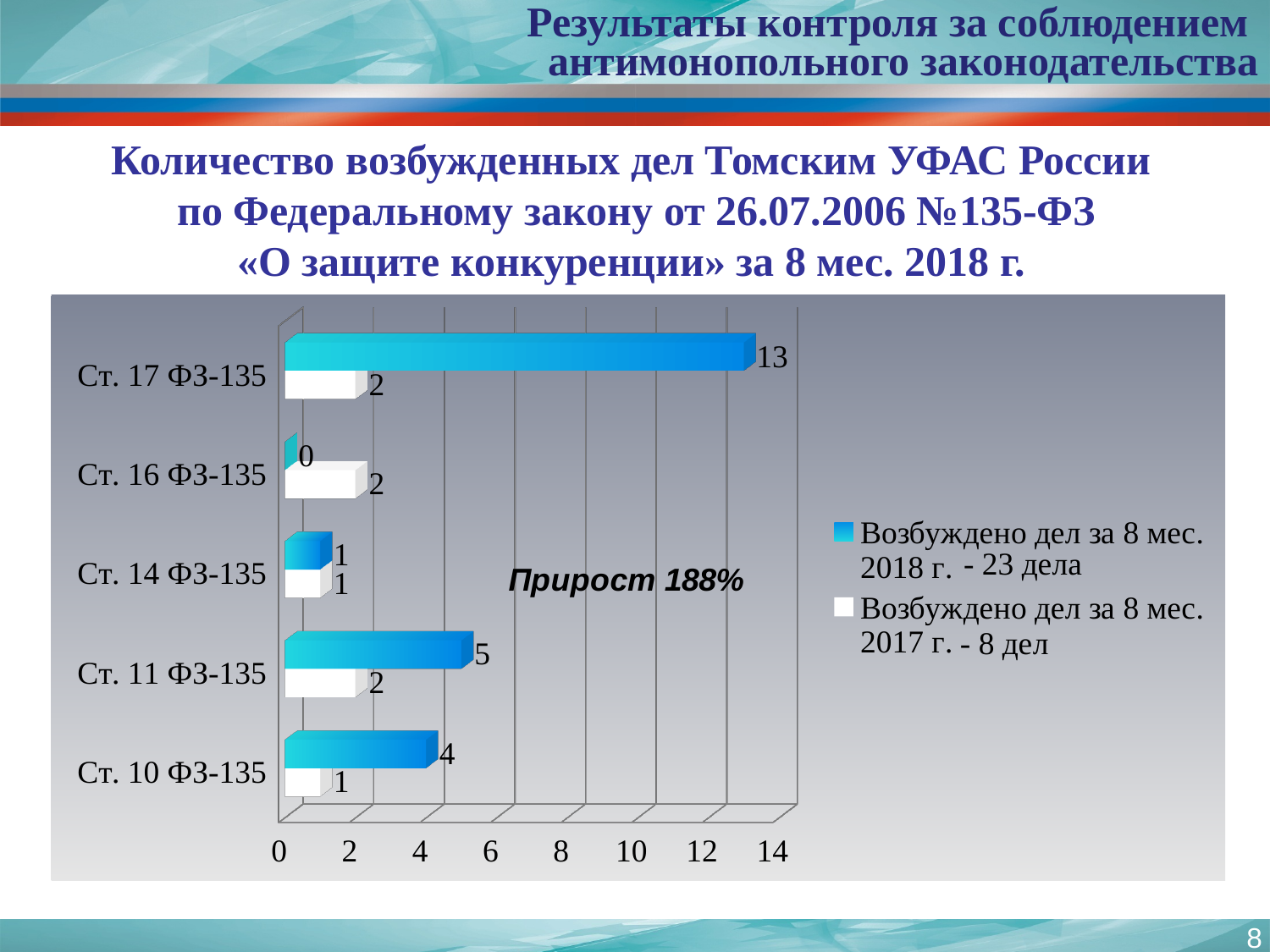
How many cases were initiated under Ст. 17 ФЗ-135 in 8 months of 2018? 13 How many categories (articles) are shown on the chart? 5 How many cases were initiated under Ст. 16 ФЗ-135 in 8 months of 2018? 0 What growth percentage (Прирост) is printed on the chart? 188% Is the 2018 value for Ст. 17 ФЗ-135 greater or less than 12? greater What is the difference between the 2018 and 2017 values for Ст. 17 ФЗ-135? 11 Which is larger for Ст. 10 ФЗ-135: the 2018 value or the 2017 value? 2018 value (4) What type of chart is shown on the slide? bar chart Which article has the highest number of cases initiated in 8 months of 2018? Ст. 17 ФЗ-135 Which article has the lowest number of cases initiated in 8 months of 2018? Ст. 16 ФЗ-135 How many series does the legend list? 2 How many cases were initiated under Ст. 11 ФЗ-135 in 8 months of 2017? 2